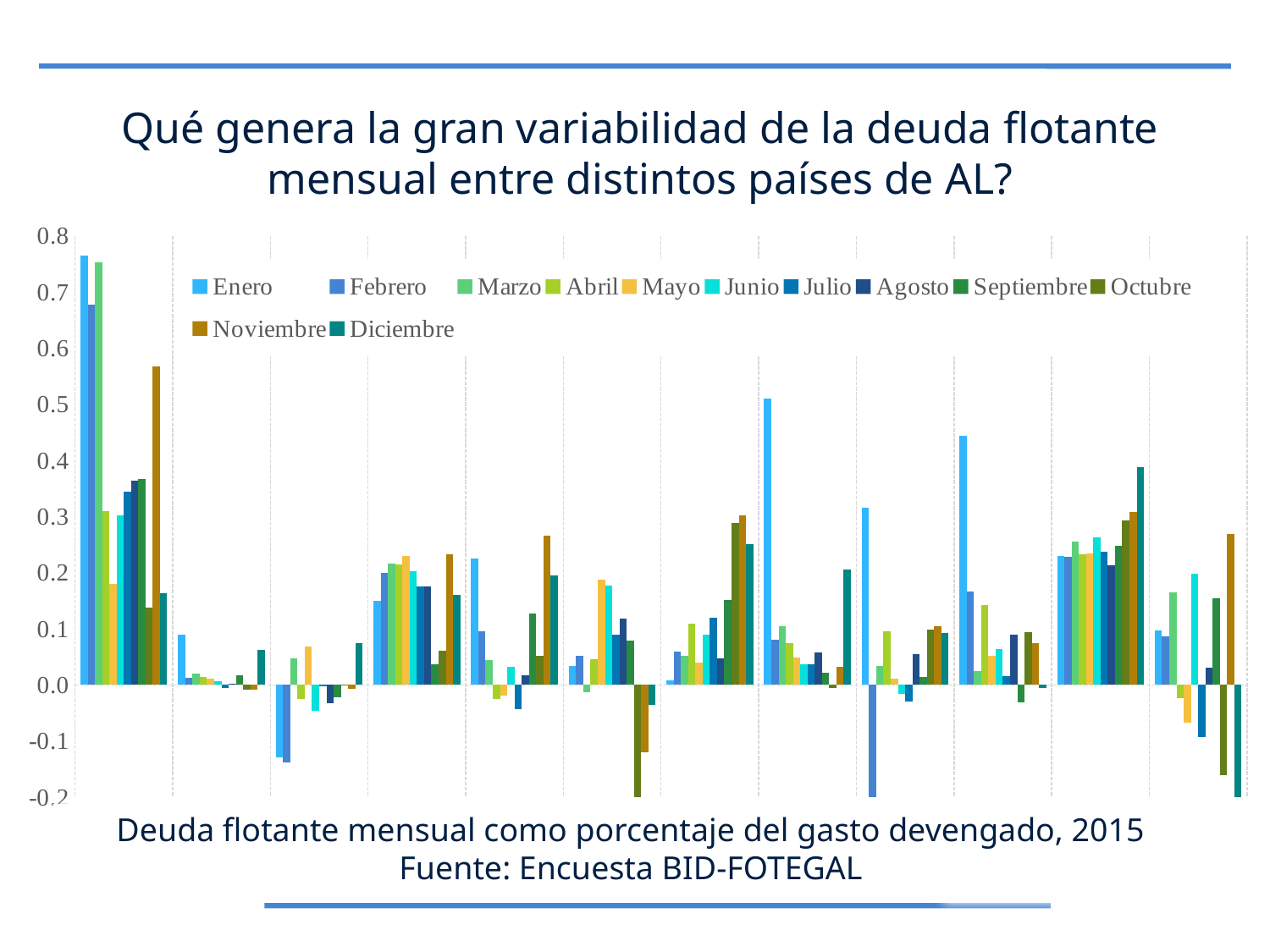
Is the tallest Noviembre bar in the chart greater or less than 0.5? greater What kind of chart is shown on the slide? bar chart How many series does the legend list? 12 What is the last series listed in the legend? Diciembre Is the tallest Enero bar in the chart greater or less than 0.7? greater What is the highest value shown on the y axis? 0.8 Which series has the tallest bar in the chart, Enero or Noviembre? Enero What is the first series listed in the legend? Enero How many groups of bars are plotted along the x axis? 12 Is the tallest bar in the chart greater or less than 0.7? greater